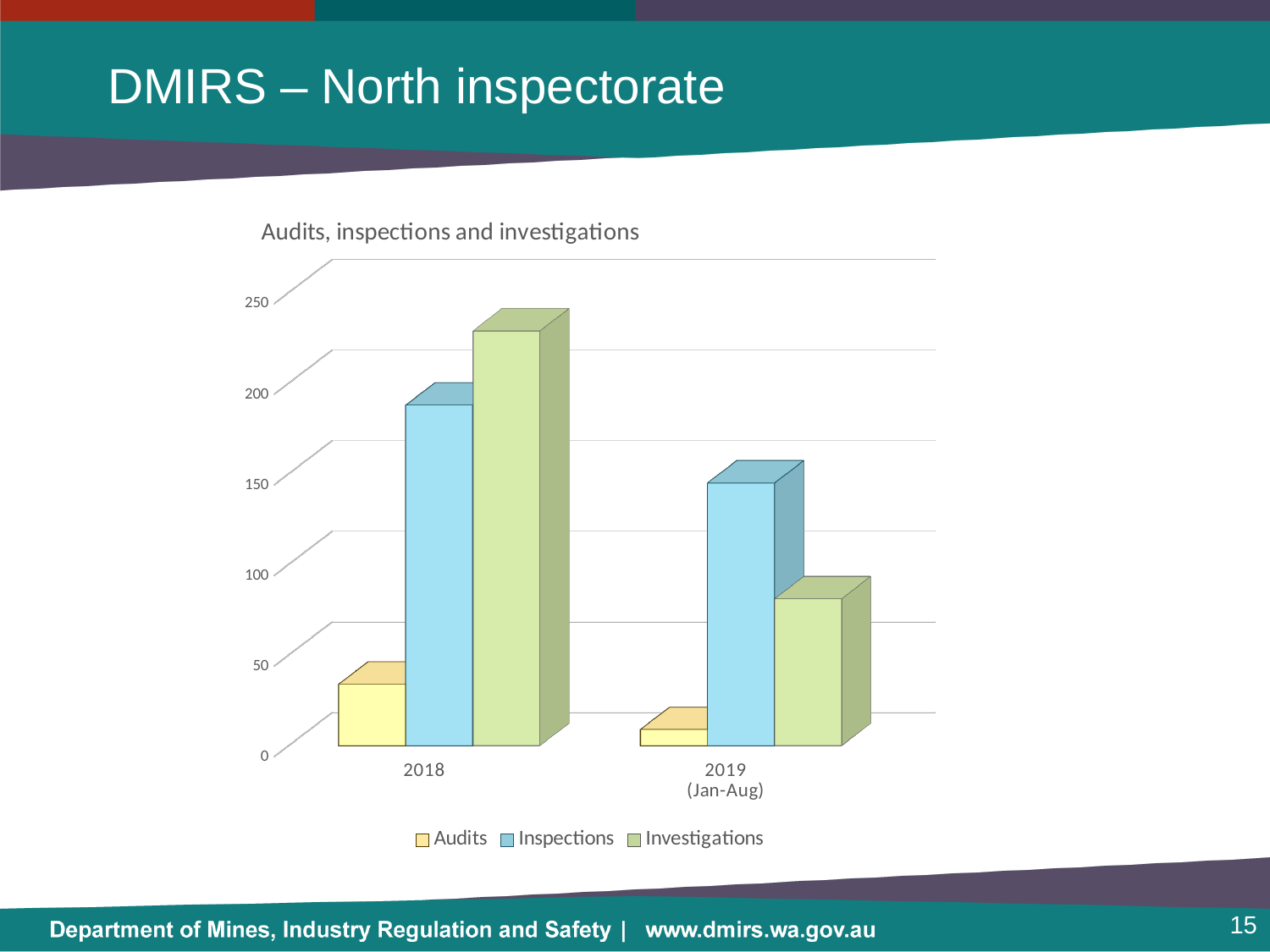
Is the value for Audits in 2018 greater or less than 50? less Which is larger: Inspections in 2018 or Inspections in 2019 (Jan-Aug)? Inspections in 2018 Do the Investigations values rise or fall from 2018 to 2019 (Jan-Aug)? Fall What is the title of the chart? Audits, inspections and investigations Is the value for Investigations in 2019 (Jan-Aug) greater or less than 100? less How many series does the legend list? 3 Which series has the highest value in 2018? Investigations What kind of chart is shown on the slide? Bar chart How many categories are shown on the x axis? 2 Which series has the lowest value in 2019 (Jan-Aug)? Audits Is the value for Investigations in 2018 greater or less than 200? greater Which series has the highest value in 2019 (Jan-Aug)? Inspections